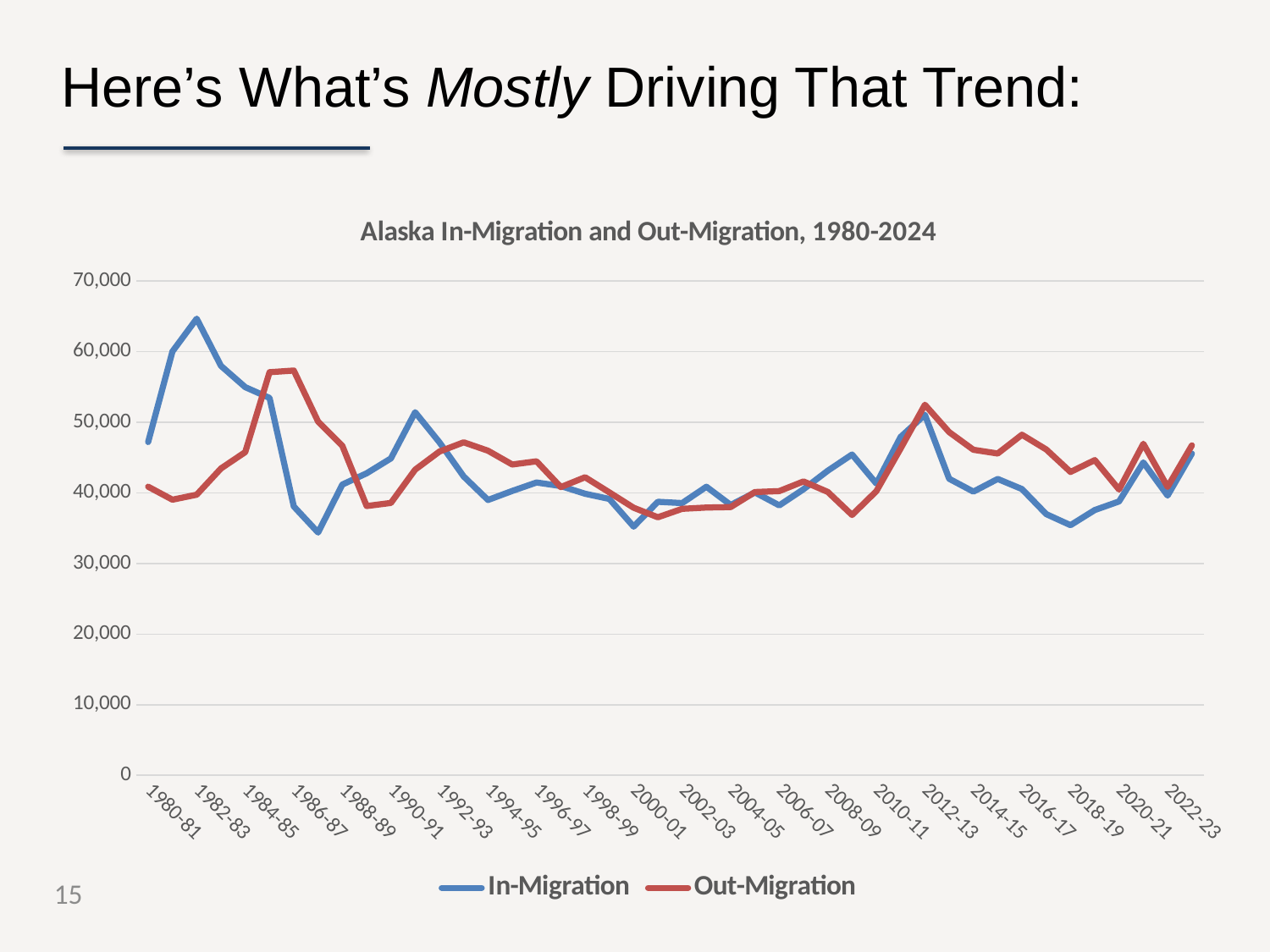
Which colour is used for the Out-Migration line? Red What kind of chart is shown on the slide? Line chart Is the In-Migration value for 1982-83 greater or less than 60,000? greater Is the Out-Migration value for 2000-01 greater or less than 40,000? less Is the Out-Migration value for 1984-85 greater or less than 50,000? less What is the title of the chart? Alaska In-Migration and Out-Migration, 1980-2024 In which year does In-Migration reach its highest value? 1982-83 In 1982-83, which is larger, In-Migration or Out-Migration? In-Migration In 1986-87, which is larger, In-Migration or Out-Migration? Out-Migration How many series does the legend list? 2 Does In-Migration rise or fall from 1980-81 to 1982-83? Rise